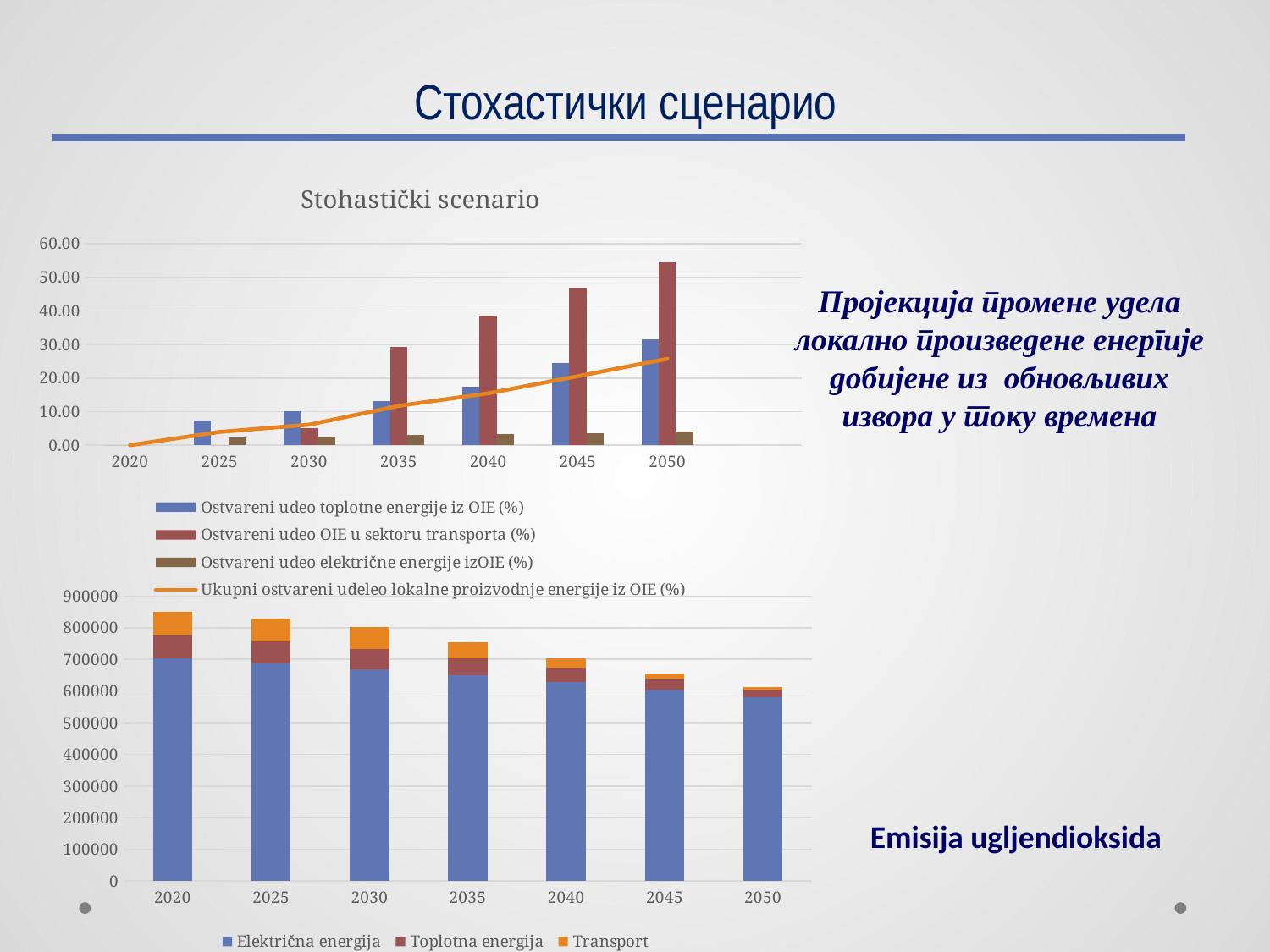
In the top chart titled 'Stohastički scenario', does the line 'Ukupni ostvareni udeleo lokalne proizvodnje energije iz OIE (%)' rise or fall from 2020 to 2050? rise In the top chart titled 'Stohastički scenario', what kind of chart is it? A bar chart combined with a line In the bottom chart (Emisija ugljendioksida), is the value for 'Električna energija' in 2020 greater or less than 600000? greater In the top chart titled 'Stohastički scenario', is the value for 'Ostvareni udeo OIE u sektoru transporta (%)' in 2050 greater or less than 50.00? greater In the top chart titled 'Stohastički scenario', how many years are shown on the x axis? 7 In the bottom chart (Emisija ugljendioksida), do the total stacked bar heights rise or fall from 2020 to 2050? fall In the bottom chart (Emisija ugljendioksida), how many series does the legend list? 3 In the top chart titled 'Stohastički scenario', in which year is the bar for 'Ostvareni udeo OIE u sektoru transporta (%)' highest? 2050 In the top chart titled 'Stohastički scenario', is the value for 'Ostvareni udeo toplotne energije iz OIE (%)' in 2050 greater or less than 20.00? greater In the bottom chart (Emisija ugljendioksida), what kind of chart is it? Stacked bar chart In the top chart titled 'Stohastički scenario', how many series does the legend list? 4 In the top chart titled 'Stohastički scenario', in 2050, which is larger: 'Ostvareni udeo toplotne energije iz OIE (%)' or 'Ostvareni udeo OIE u sektoru transporta (%)'? Ostvareni udeo OIE u sektoru transporta (%)